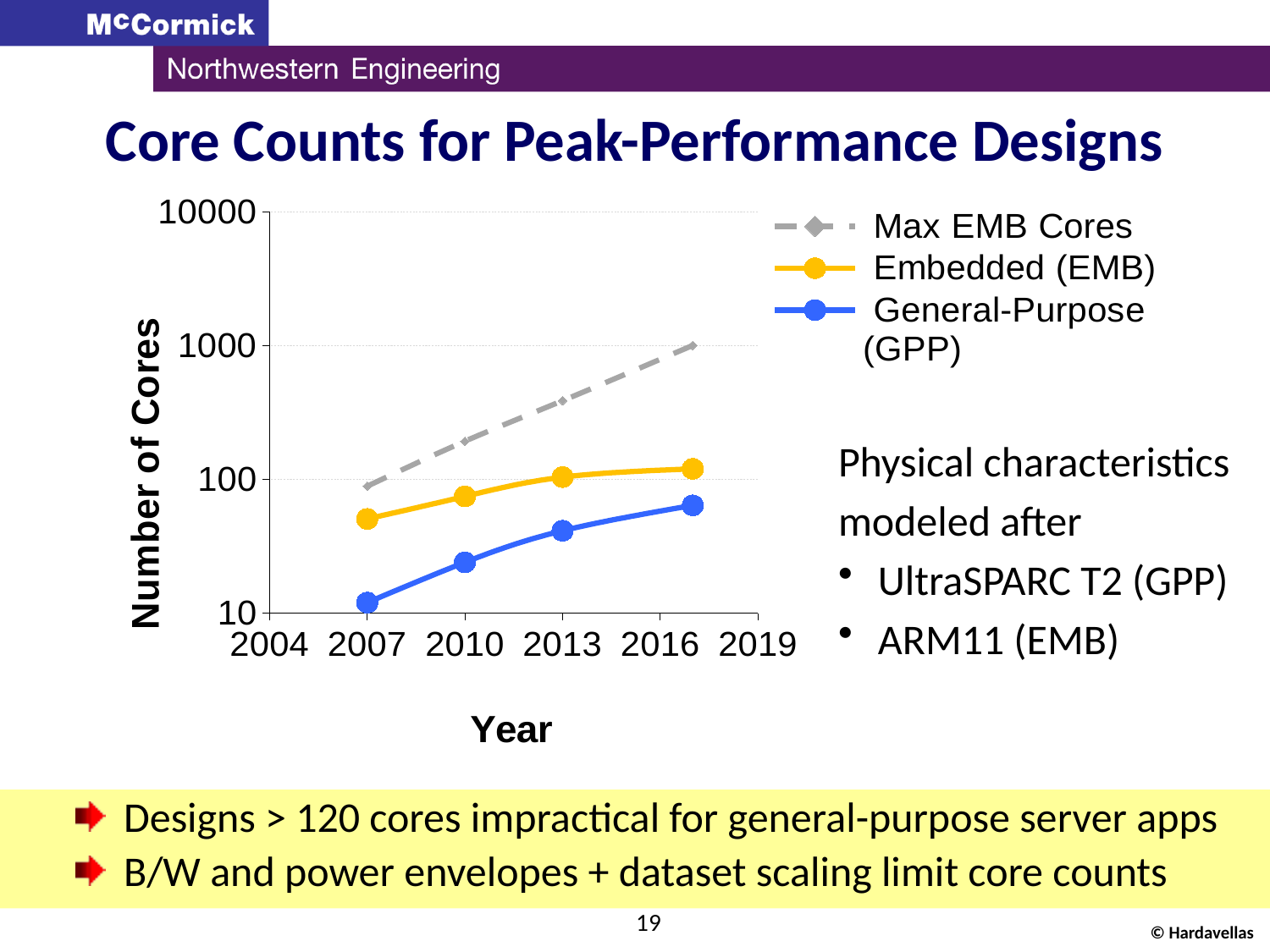
Does the General-Purpose (GPP) series rise or fall over the years shown? rise What is the label of the y axis of the chart? Number of Cores What kind of chart is shown on the slide? line chart Is the value for Embedded (EMB) in 2007 greater or less than 100? less Which series has the lowest number of cores across the years shown? General-Purpose (GPP) Is the value for Max EMB Cores in 2013 greater or less than 100? greater Does the Embedded (EMB) series rise or fall over the years shown? rise How many series does the chart legend list? 3 Is the value for General-Purpose (GPP) in 2017 greater or less than 100? less Which series has the highest number of cores across the years shown? Max EMB Cores What is the title of the chart on the slide? Core Counts for Peak-Performance Designs In 2013, which series has more cores, Embedded (EMB) or General-Purpose (GPP)? Embedded (EMB)